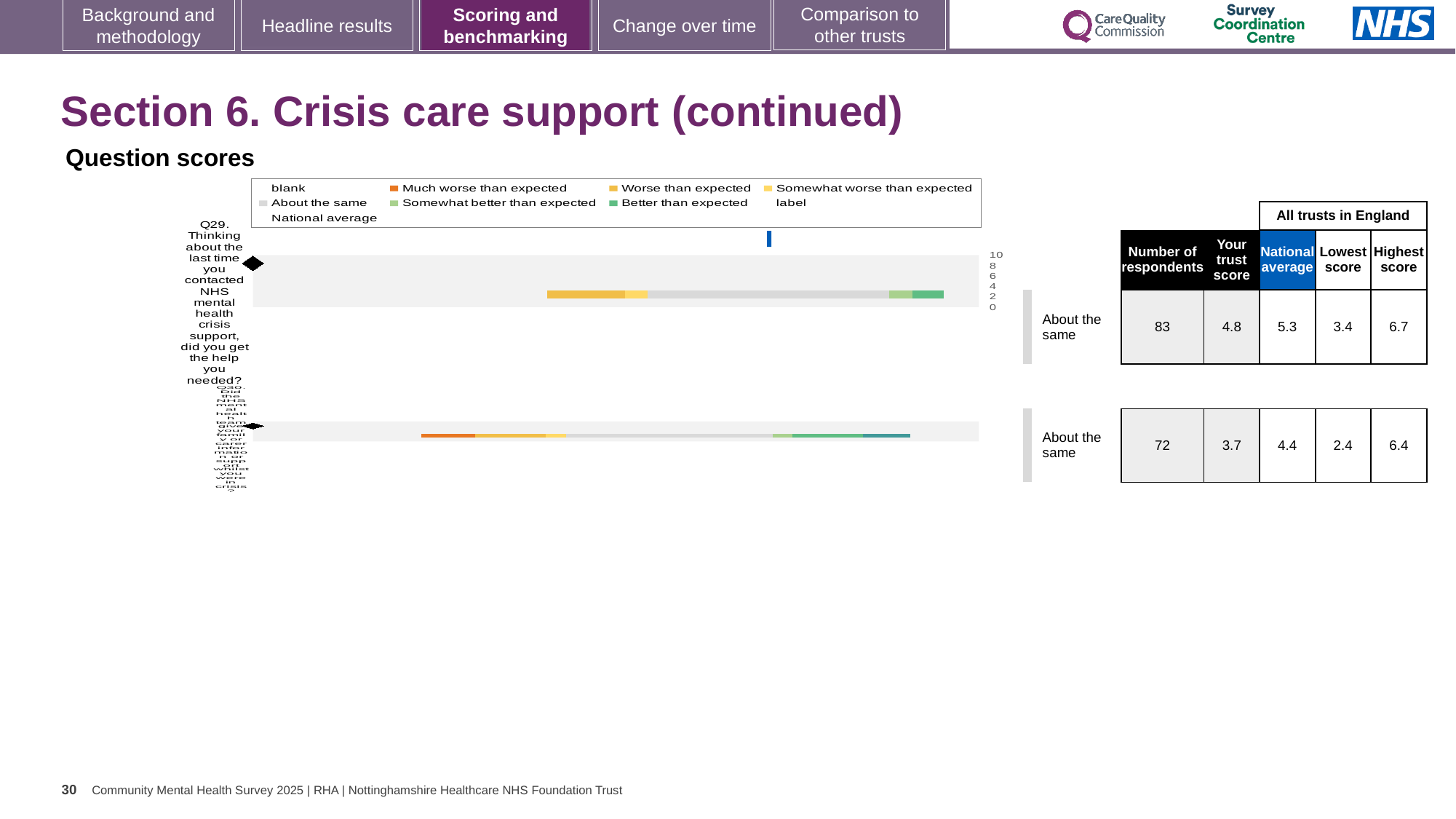
What is the national average for Q30? 4.4 What is the highest score across all trusts in England for Q29? 6.7 What is the difference between the highest score and the lowest score for Q29? 3.3 What is the difference between the national average and the trust score for Q30? 0.7 Which is larger for Q29, the trust score or the national average? national average What is the trust score for Q29? 4.8 How is the trust's result for Q30 categorised compared with what is expected? About the same How many questions (categories) are plotted in the chart? 2 What is the lowest score across all trusts in England for Q30? 2.4 What kind of chart is shown under 'Question scores'? bar chart What is the number of respondents for Q29? 83 What is the highest value shown on the chart's numeric axis? 10